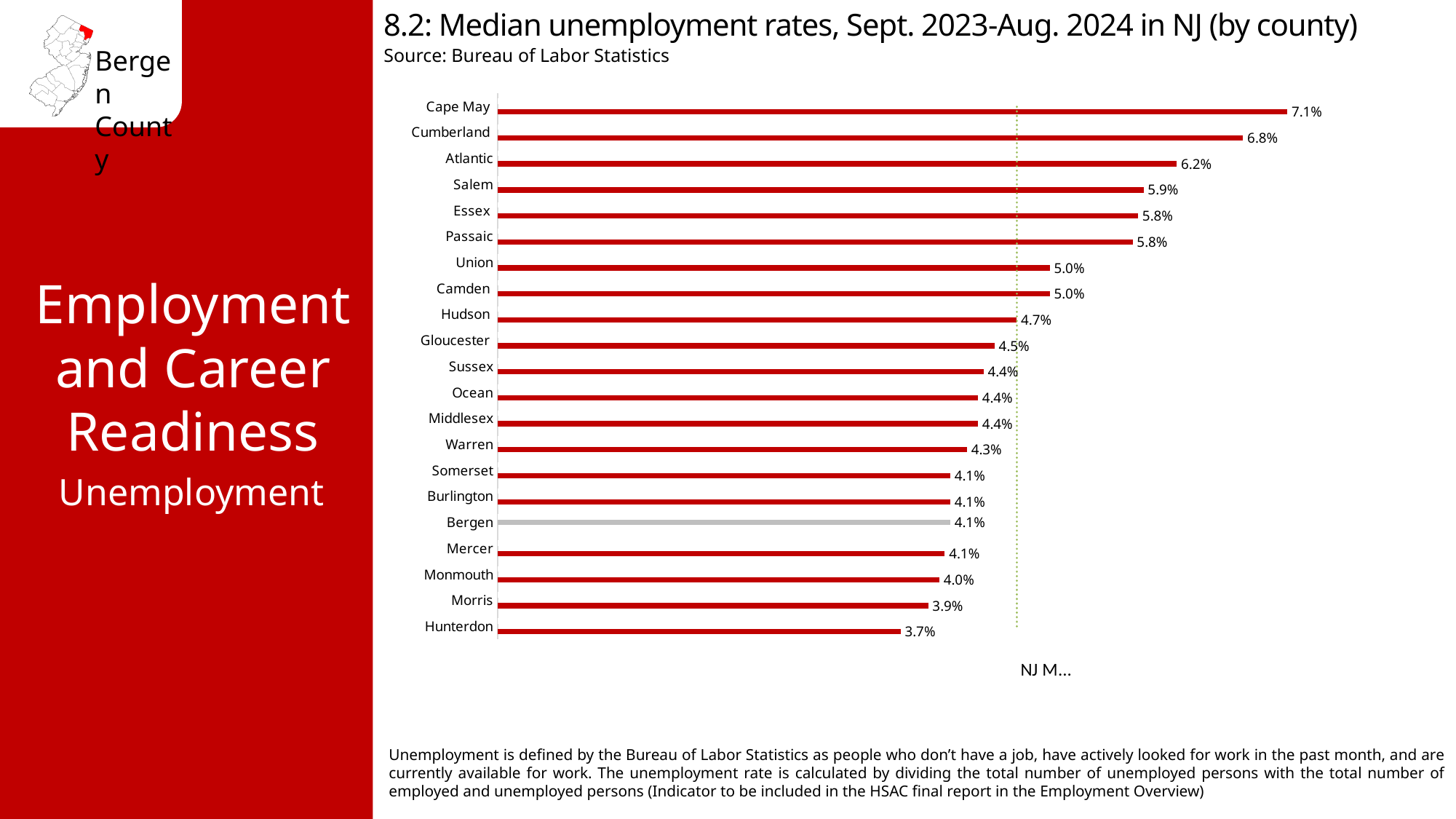
Which county has the highest median unemployment rate? Cape May What is the median unemployment rate for Hudson County? 4.7% What is the median unemployment rate for Cumberland County? 6.8% Which county's bar is shown in grey instead of red? Bergen Which county has the lowest median unemployment rate? Hunterdon Which county has a higher median unemployment rate, Morris or Gloucester? Gloucester What is the difference between the median unemployment rates of Atlantic and Bergen? 2.1% What kind of chart is used to show the median unemployment rates? Bar chart What is the median unemployment rate for Bergen County? 4.1% Which county has a higher median unemployment rate, Salem or Union? Salem How many counties are shown in the chart? 21 What is the difference between the median unemployment rates of Cape May and Hunterdon? 3.4%